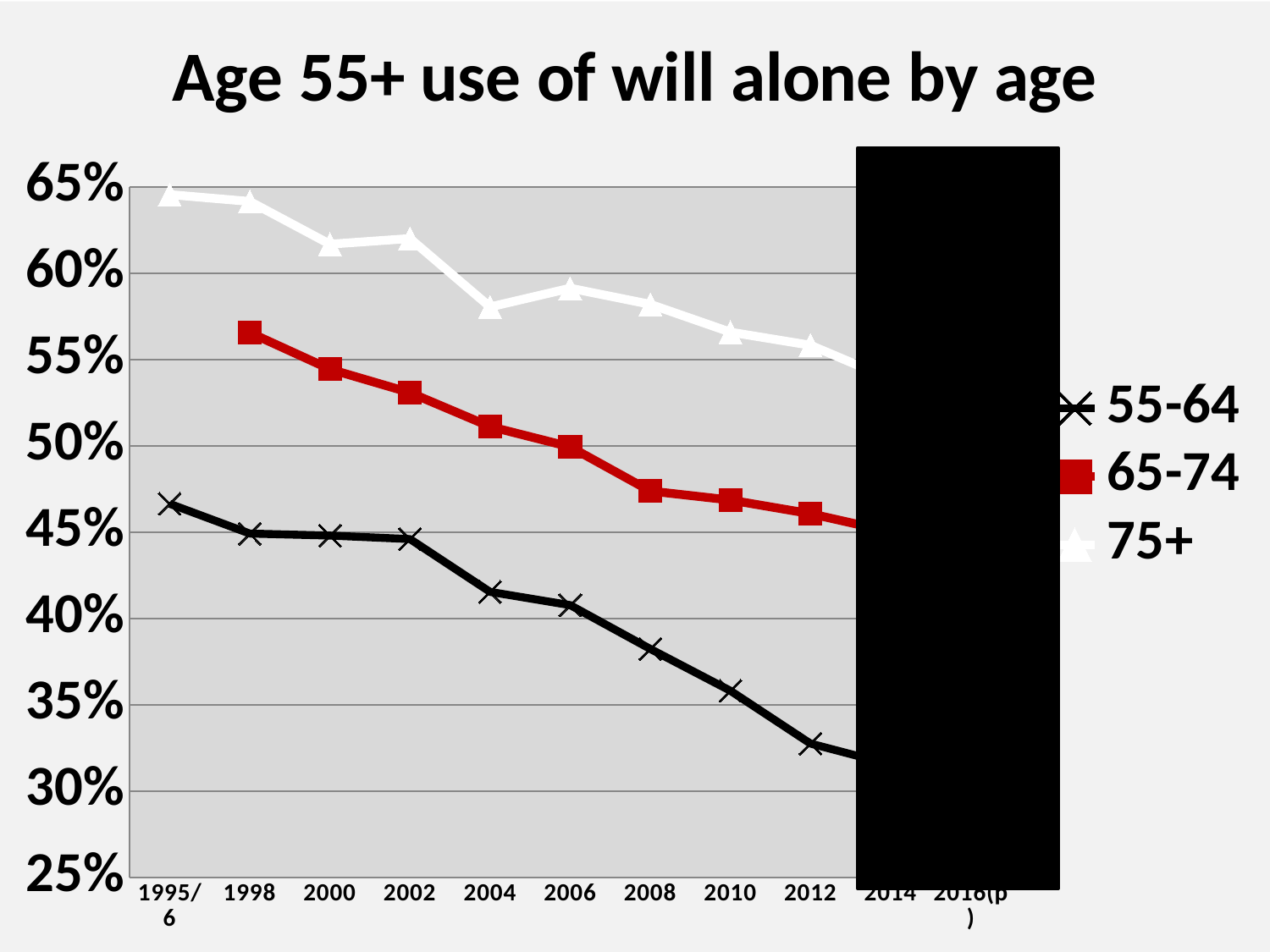
Which series is drawn in red? 65-74 Is the value for the 55-64 series in 1995/6 greater or less than 45%? greater How many series does the legend list? 3 Is the value for the 75+ series in 2004 greater or less than 60%? less Which series has the highest value in 2002? 75+ Is the value for the 65-74 series in 2012 greater or less than 50%? less What kind of chart is shown on the slide? line chart What is the title of the chart? Age 55+ use of will alone by age Does the 55-64 series generally rise or fall from 1995/6 to 2012? fall